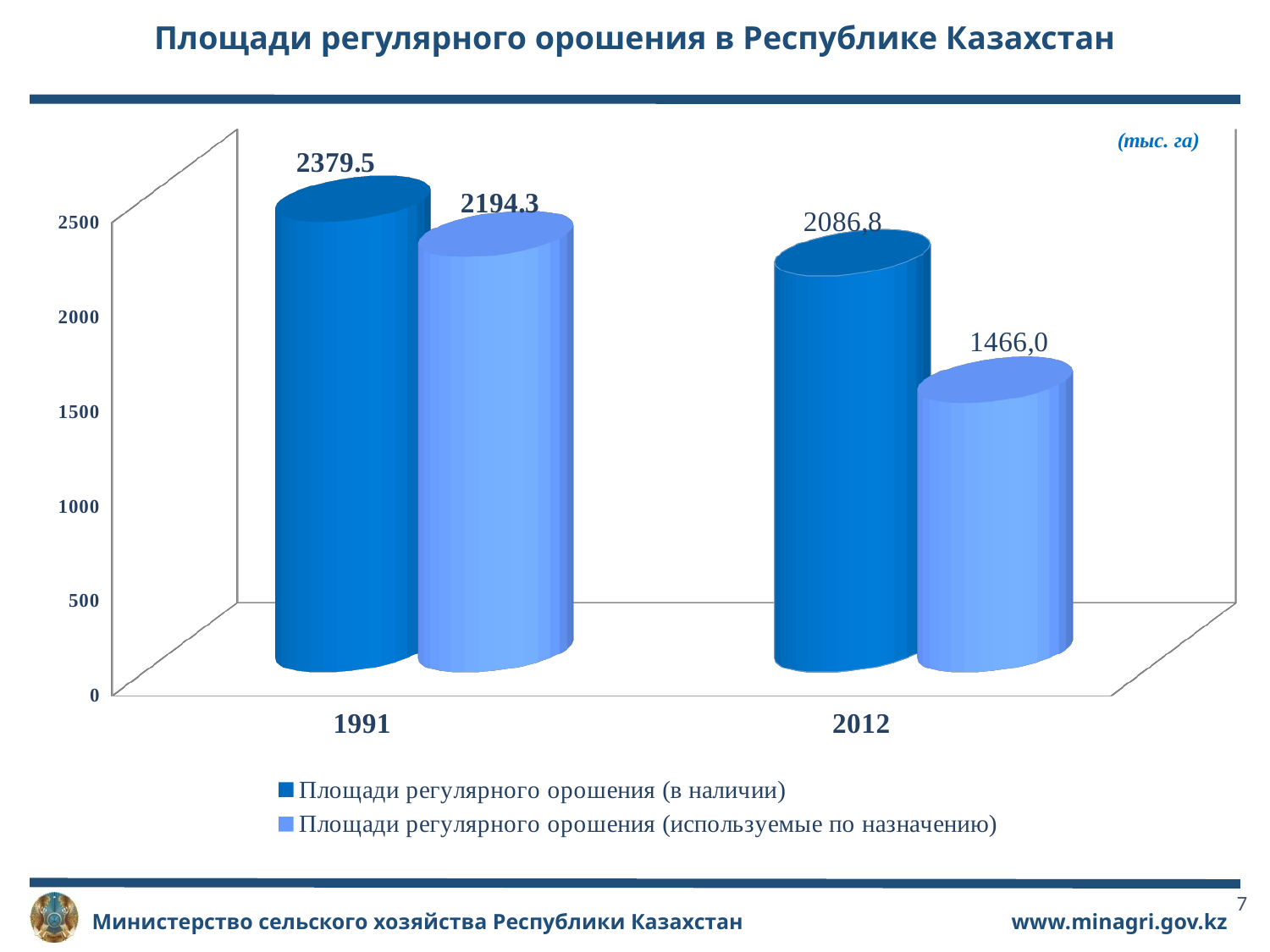
Which year has the highest value for 'Площади регулярного орошения (в наличии)'? 1991 How many years (categories) are shown on the x axis? 2 What is the value for 2012 in the series 'Площади регулярного орошения (используемые по назначению)'? 1466,0 Which is larger: the 'используемые по назначению' value for 1991 or for 2012? 1991 What is the difference between the two series values for 1991? 185.2 How many series does the legend list? 2 What is the difference between the 'в наличии' values for 1991 and 2012? 292.7 What kind of chart is shown on the slide? Bar chart What is the value for 1991 in the series 'Площади регулярного орошения (используемые по назначению)'? 2194.3 Which bar on the chart has the lowest value? 2012, Площади регулярного орошения (используемые по назначению) What is the value for 2012 in the series 'Площади регулярного орошения (в наличии)'? 2086,8 What is the value for 1991 in the series 'Площади регулярного орошения (в наличии)'? 2379.5